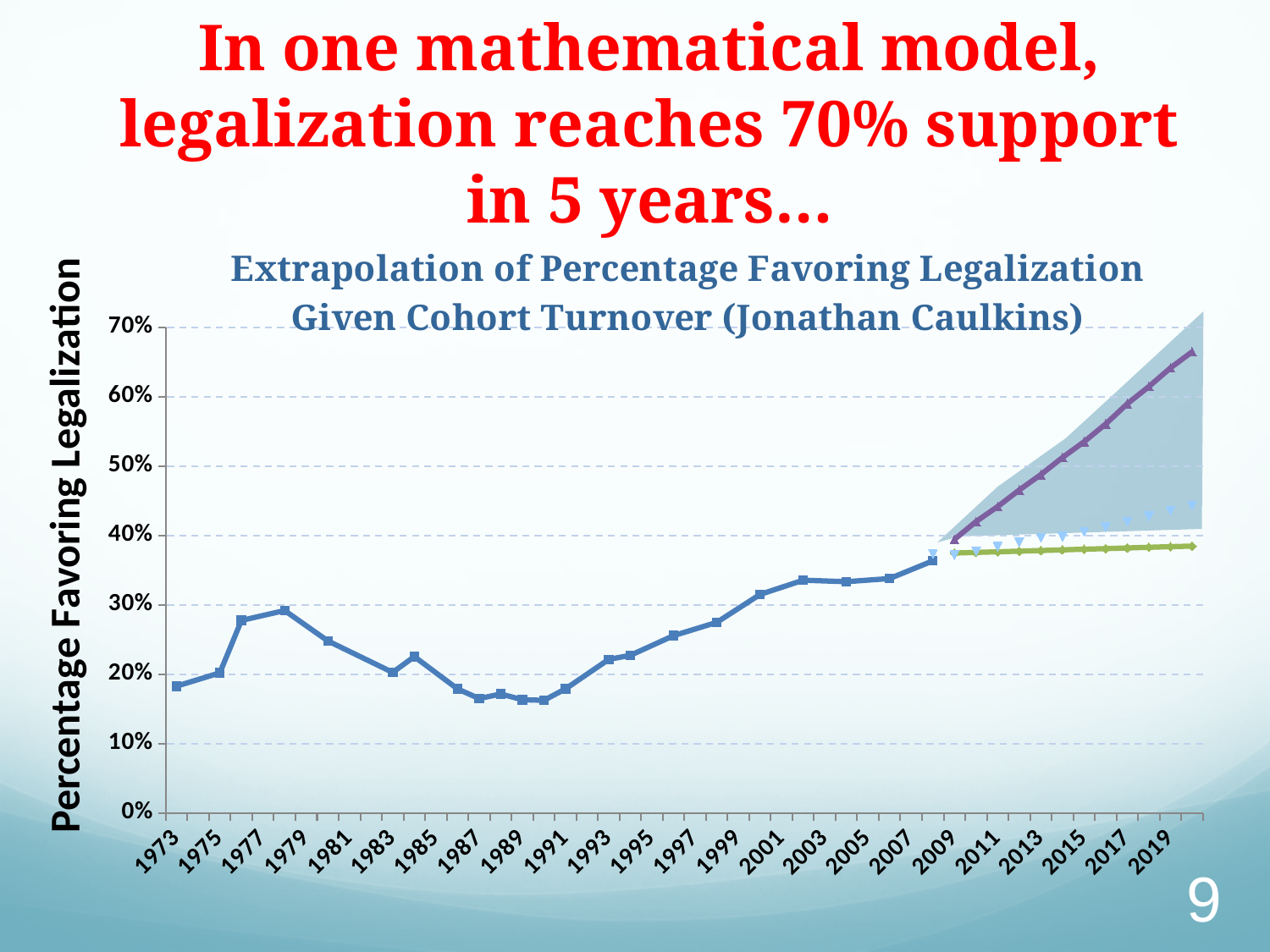
What kind of chart is shown on the slide? line chart Is the value for 1989 greater or less than 20%? less Is the value for 2003 greater or less than 30%? greater What is the label on the vertical axis of the chart? Percentage Favoring Legalization Do the values on the blue line rise or fall between 1991 and 2007? rise Is the value of the upper (purple) projection line at 2019 greater or less than 60%? greater Which year has the larger value, 1977 or 1987? 1977 What is the title of the chart? Extrapolation of Percentage Favoring Legalization Given Cohort Turnover (Jonathan Caulkins) How many year labels are shown on the x axis? 24